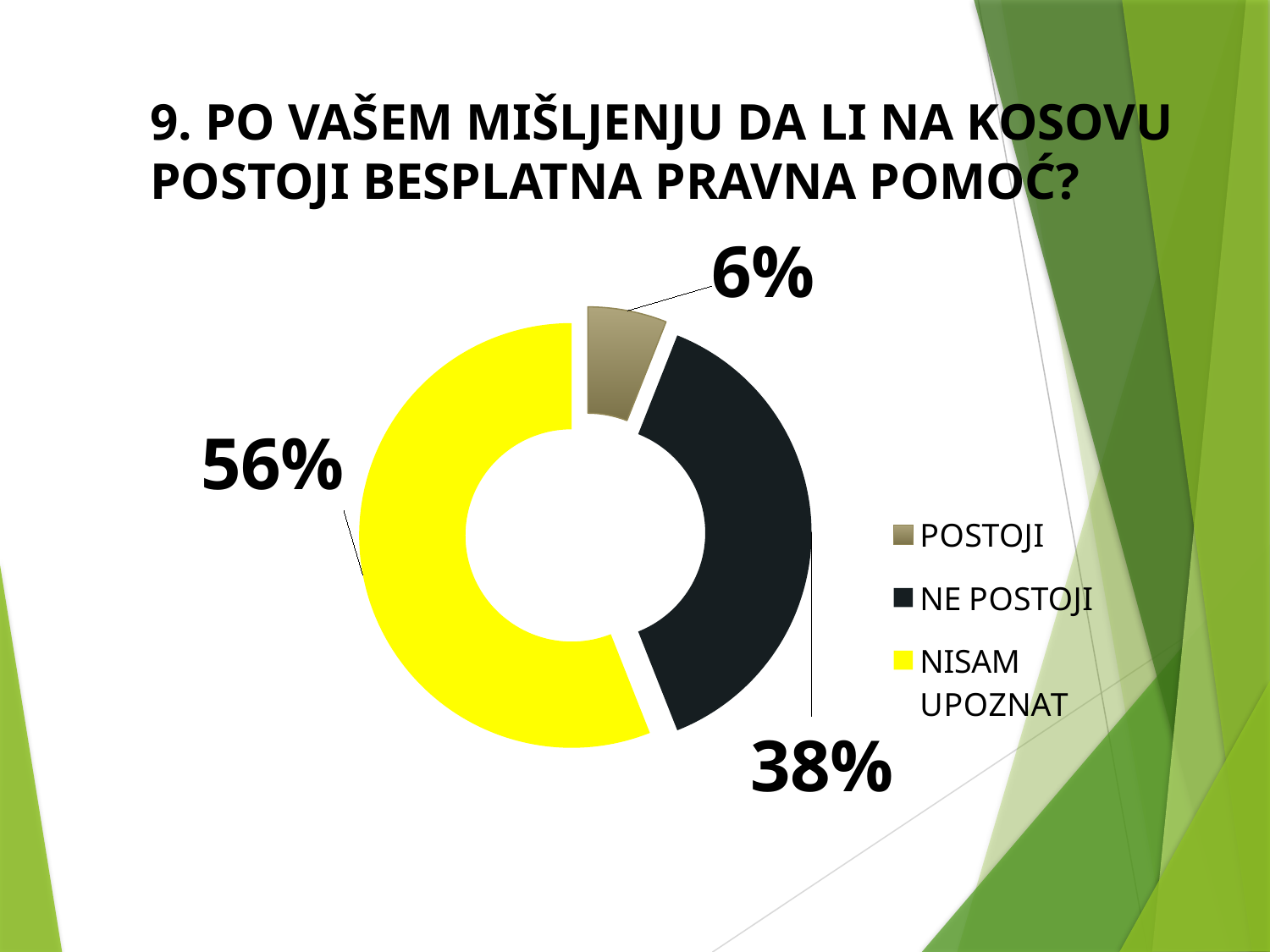
What percentage of respondents answered NE POSTOJI? 38% What percentage of respondents answered NISAM UPOZNAT? 56% What kind of chart is shown on the slide? Doughnut chart Which is larger, the share for NE POSTOJI or the share for POSTOJI? NE POSTOJI What is the difference in percentage points between NE POSTOJI and POSTOJI? 32 What is the difference in percentage points between NISAM UPOZNAT and NE POSTOJI? 18 Which response has the smallest share? POSTOJI Which response has the largest share? NISAM UPOZNAT How many categories does the chart show? 3 What percentage of respondents answered POSTOJI? 6% What colour represents NISAM UPOZNAT in the chart? Yellow What is the title of the slide containing the chart? 9. PO VAŠEM MIŠLJENJU DA LI NA KOSOVU POSTOJI BESPLATNA PRAVNA POMOĆ?